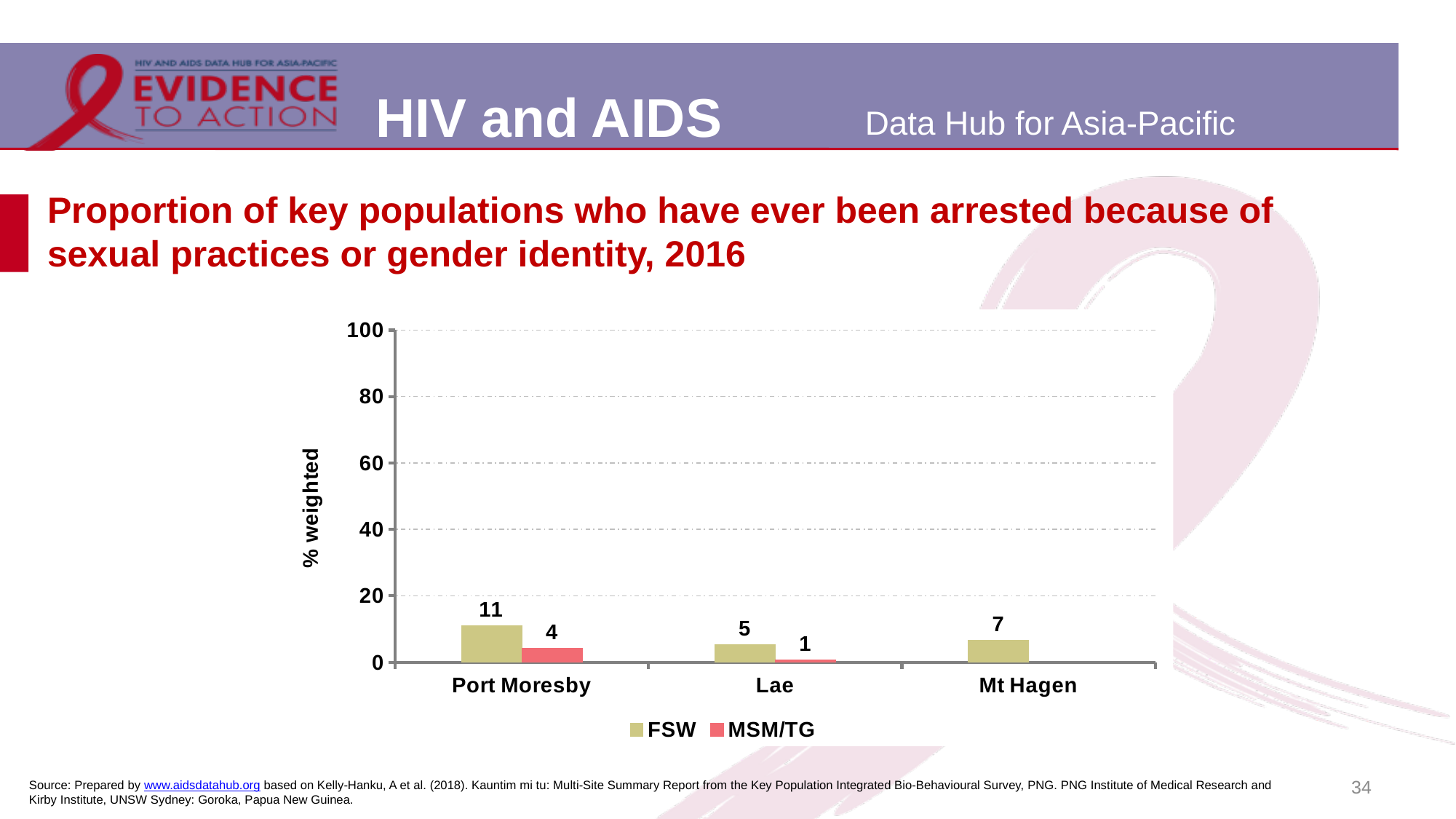
What is the MSM/TG value for Lae? 1 What is the label of the y axis? % weighted Which city has the lowest FSW value? Lae What is the FSW value for Mt Hagen? 7 Which city has the highest FSW value? Port Moresby How many cities are shown on the x axis? 3 Is the FSW value for Port Moresby greater or less than 20? less How many series does the legend list? 2 What is the difference between the FSW and MSM/TG values for Port Moresby? 7 What kind of chart is shown? bar chart What is the FSW value for Port Moresby? 11 Which is larger, the FSW value for Lae or the FSW value for Mt Hagen? Mt Hagen